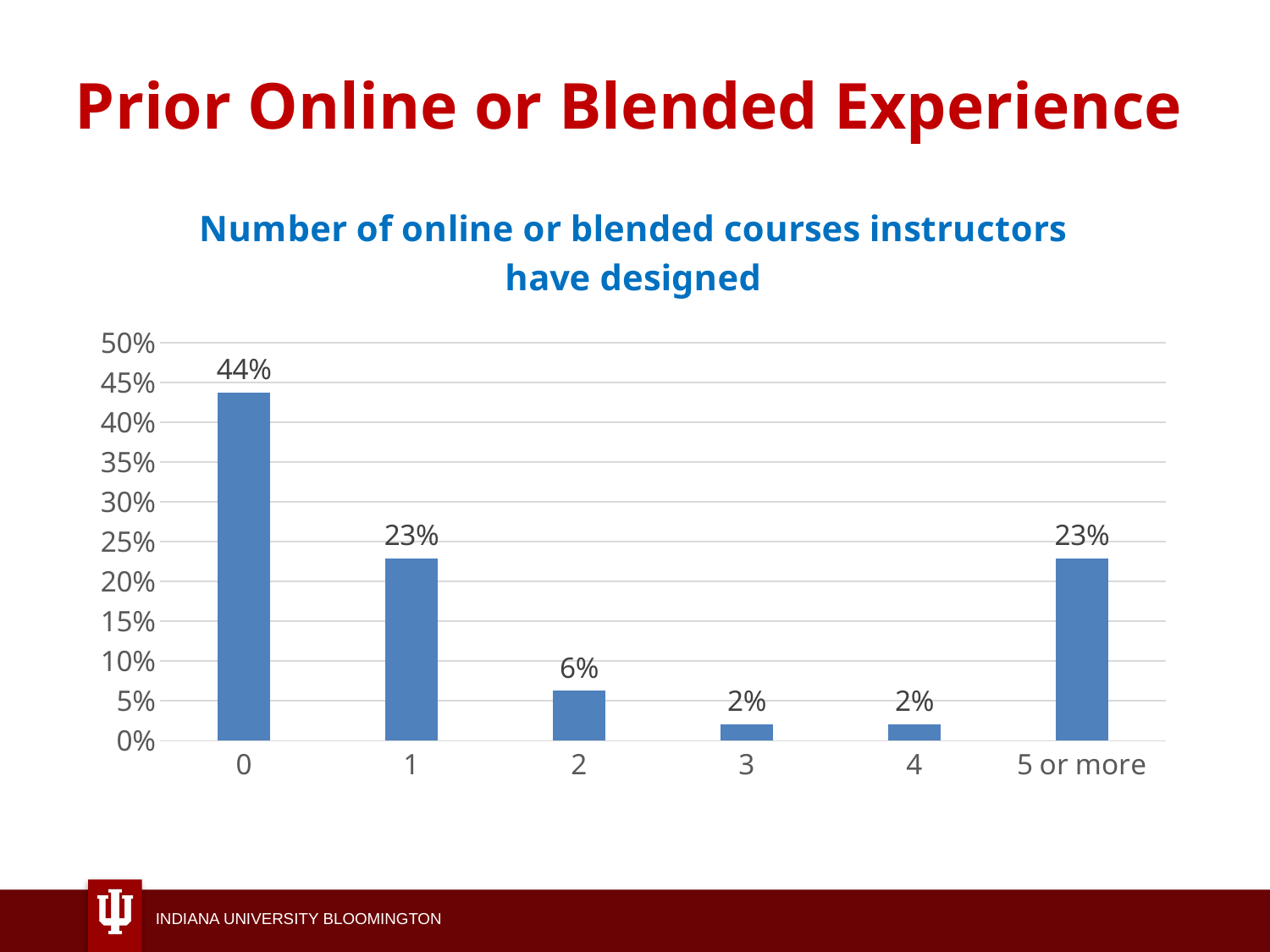
What is the difference between the values for 2 courses and 3 courses? 4% What is the highest value shown on the y axis? 50% Which category has the highest value? 0 What is the difference between the values for 0 courses and 1 course? 21% What kind of chart is shown on the slide? bar chart What percentage of instructors have designed 2 online or blended courses? 6% What percentage of instructors have designed 0 online or blended courses? 44% Is the value for 0 courses greater or less than 40%? greater What is the value for the '5 or more' category? 23% How many categories are shown on the x axis? 6 What is the title of the chart? Number of online or blended courses instructors have designed Which is larger, the value for 1 course or the value for 2 courses? 1 course